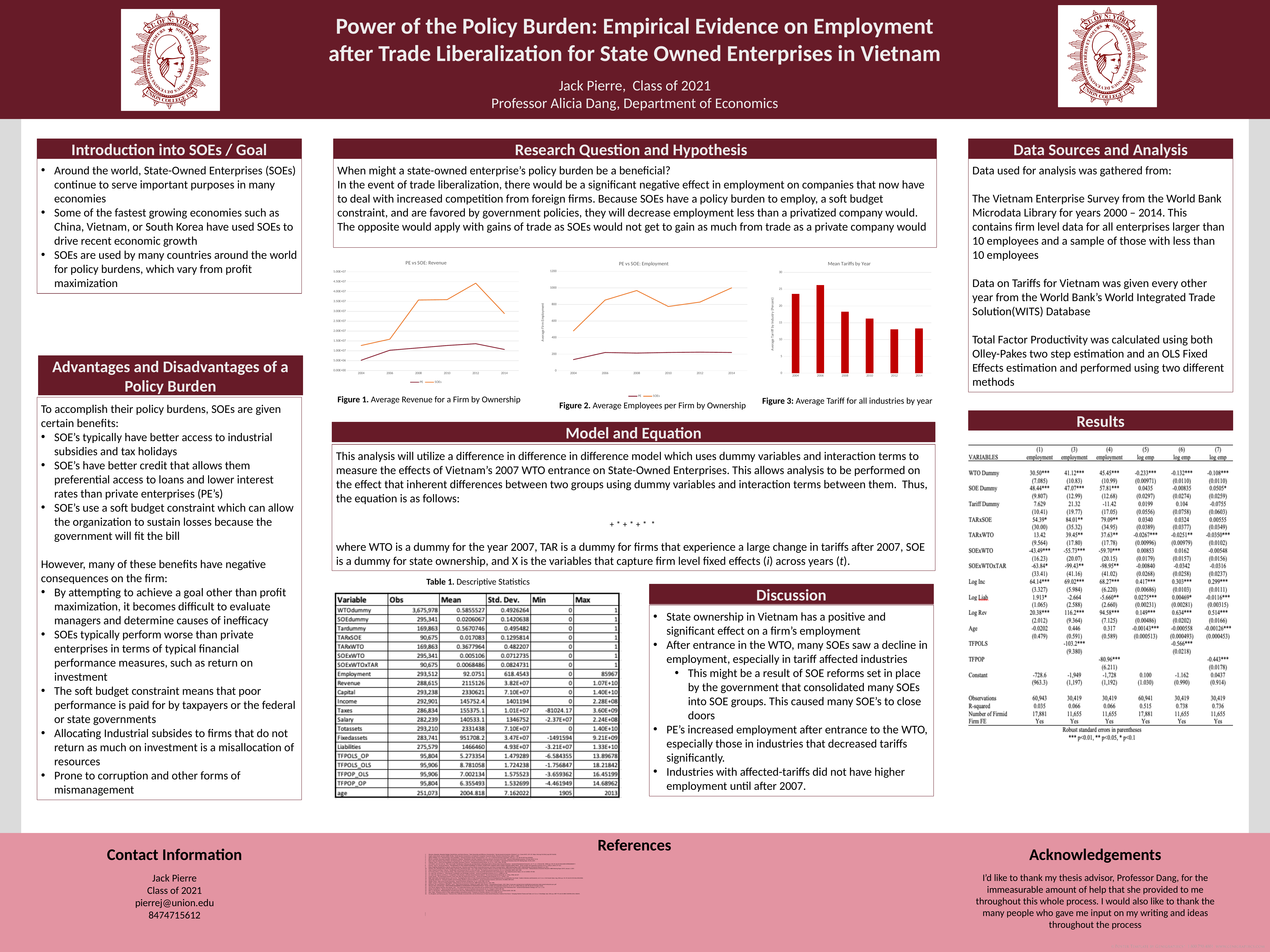
What kind of chart is the 'PE vs SOE: Revenue' chart? line chart How many years are shown in the 'Mean Tariffs by Year' chart? 6 In the 'PE vs SOE: Employment' chart, is the SOEs value for 2014 greater or less than 800? greater In the 'Mean Tariffs by Year' chart, is the value for 2004 greater or less than 20? greater In the 'Mean Tariffs by Year' chart, is the value for 2012 greater or less than 15? less In the 'PE vs SOE: Revenue' chart, in which year does the SOEs series reach its highest value? 2012 In the 'PE vs SOE: Employment' chart, in which year is the SOEs series at its lowest? 2004 How many series does the legend of the 'PE vs SOE: Revenue' chart list? 2 In the 'PE vs SOE: Revenue' chart, which series has the higher value in 2012, PE or SOEs? SOEs In the 'Mean Tariffs by Year' chart, do the values generally rise or fall from 2006 to 2014? fall What kind of chart is the 'Mean Tariffs by Year' chart? bar chart In the 'Mean Tariffs by Year' chart, which year has the highest mean tariff? 2006